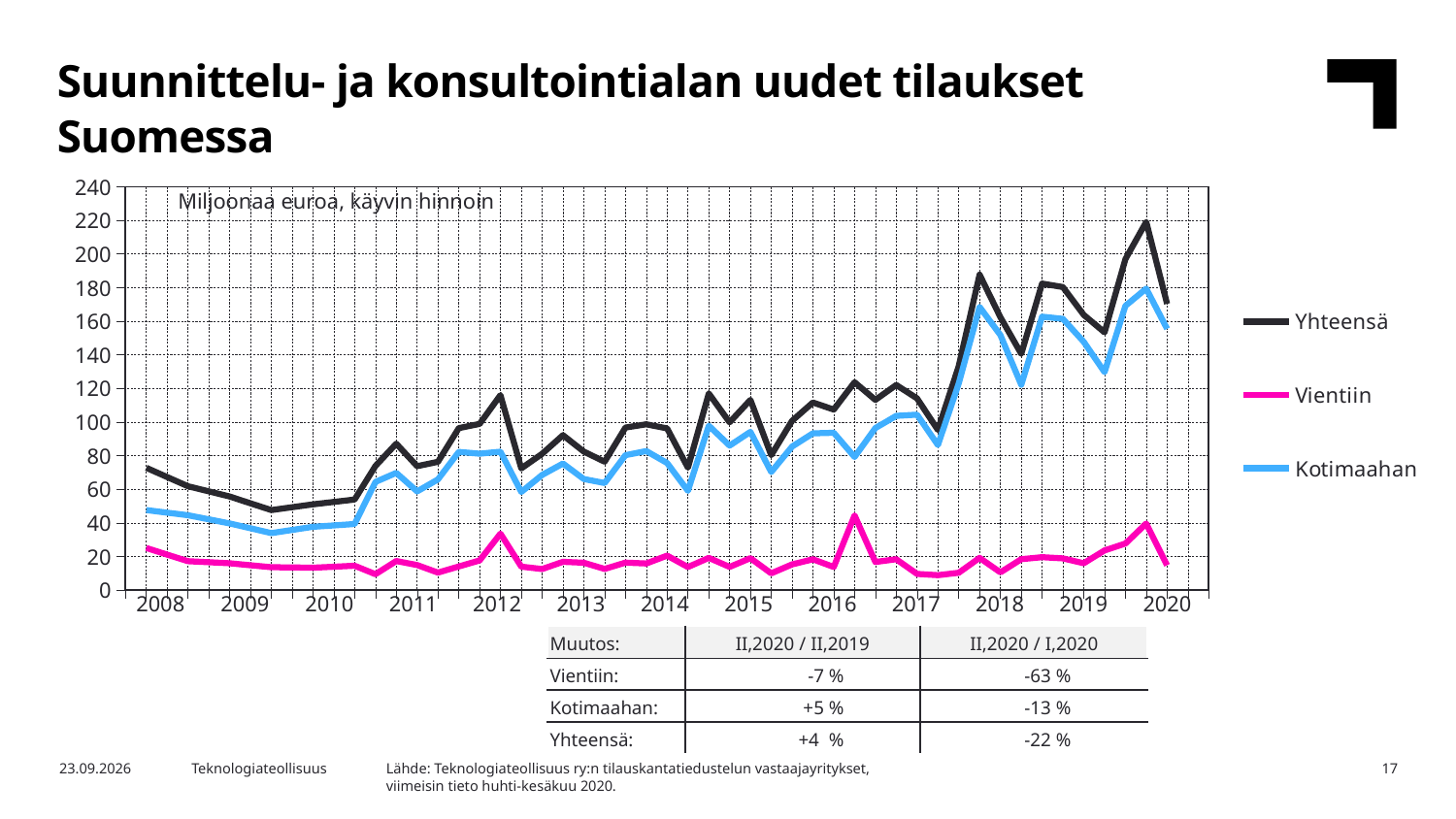
Is the value of the Vientiin line at the start of 2008 greater or less than 40? less What unit label is shown inside the chart area? Miljoonaa euroa, käyvin hinnoin How many series does the chart legend list? 3 Is the value of the Kotimaahan line at the start of 2008 greater or less than 60? less What are the three series named in the chart legend? Yhteensä, Vientiin, Kotimaahan What type of chart is shown on the slide? Line chart Does the Yhteensä line generally rise or fall from 2017 to the end of 2019? rise How many year labels are shown on the x axis? 13 Which series has the lowest values throughout the chart? Vientiin Which series has the highest values throughout the chart? Yhteensä In 2018, which series has larger values, Kotimaahan or Vientiin? Kotimaahan Is the peak value of the Yhteensä line near the end of 2019 greater or less than 200? greater